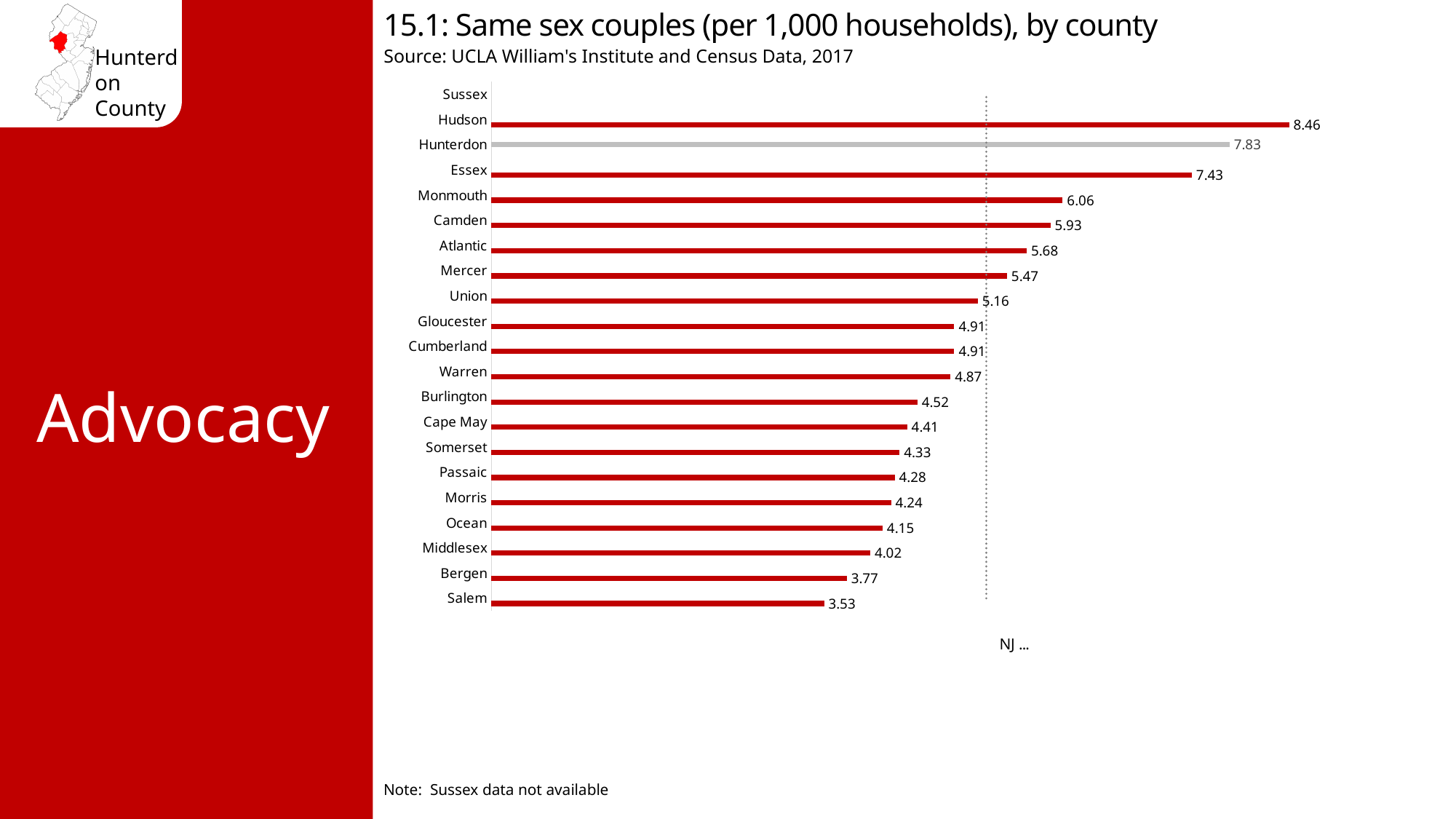
According to the note, which county's data is not available? Sussex Which has a larger value, Monmouth or Camden? Monmouth What is the difference between the values for Hudson and Hunterdon? 0.63 What kind of chart is shown? Bar chart Which county has the lowest value shown? Salem Which has a larger value, Bergen or Middlesex? Middlesex What is the value for Salem? 3.53 What is the value for Essex? 7.43 Which county's bar is coloured grey instead of red? Hunterdon Which county has the highest value shown? Hudson What is the value for Hunterdon? 7.83 How many counties are listed on the chart's axis? 21